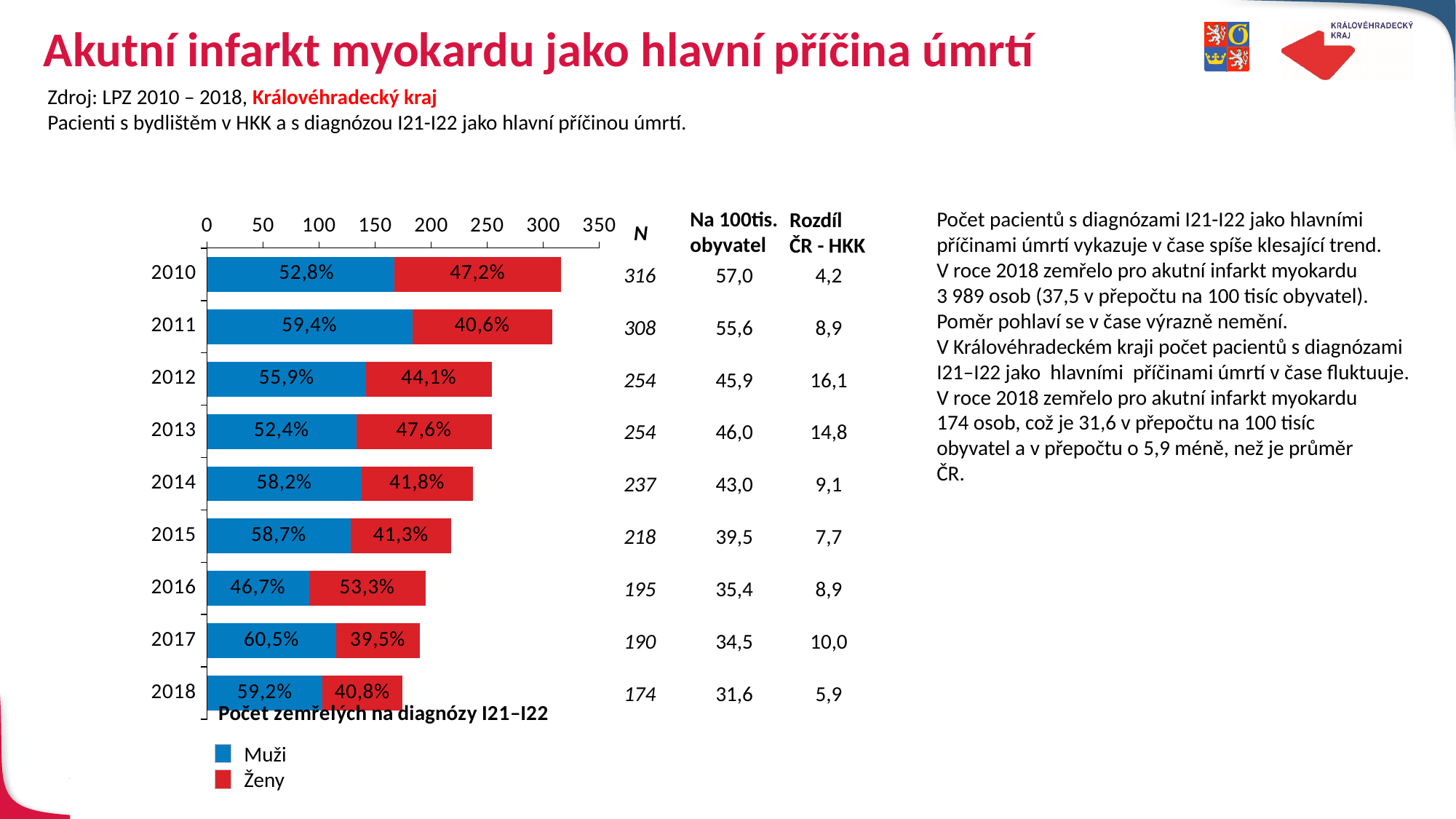
Is the total bar length for 2010 greater or less than 300? greater Which year has the shortest bar (lowest total number of deaths)? 2018 In 2016, which share is larger, men (Muži) or women (Ženy)? Ženy Do the total bar lengths generally rise or fall from 2010 to 2018? Fall How many years (categories) are shown in the chart? 9 Is the total bar length for 2018 greater or less than 200? less Which year has the longest bar (highest total number of deaths)? 2010 What type of chart is shown on the slide? Stacked bar chart What percentage share do men (Muži) have in the 2010 bar? 52,8% How many series does the legend list? 2 What percentage share do women (Ženy) have in the 2016 bar? 53,3% What is the men's (Muži) share shown for 2017? 60,5%